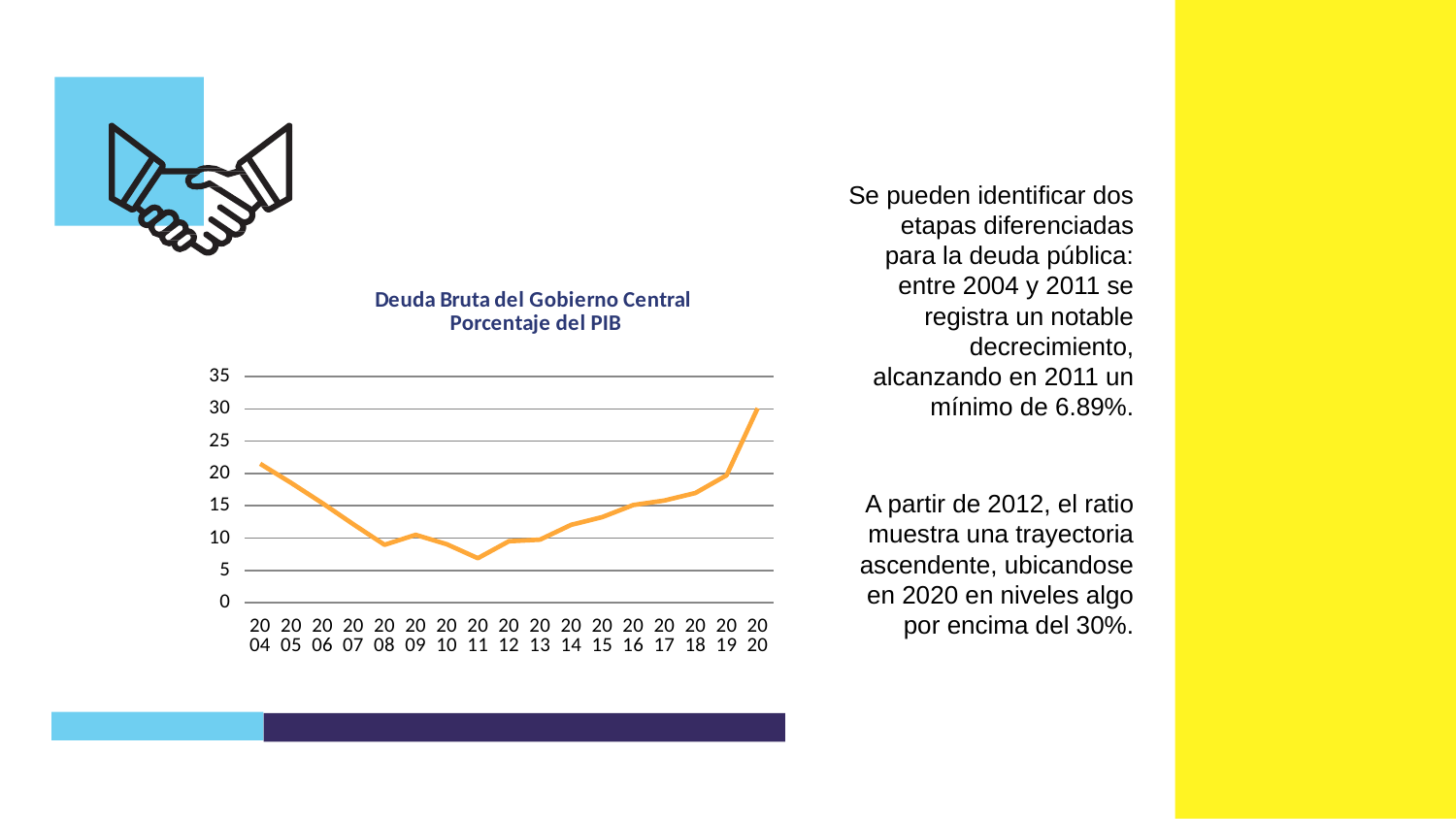
Is the value for 2011 greater or less than 10? less What kind of chart is shown on the slide? line chart Do the values rise or fall between 2004 and 2011? fall Is the value for 2020 greater or less than 25? greater Is the value for 2004 greater or less than 15? greater Which year has the larger value, 2005 or 2015? 2005 Do the values rise or fall between 2012 and 2020? rise In which year does the line reach its lowest value? 2011 How many years are plotted on the x axis of the chart? 17 What is the title of the chart? Deuda Bruta del Gobierno Central Porcentaje del PIB In which year does the line reach its highest value? 2020